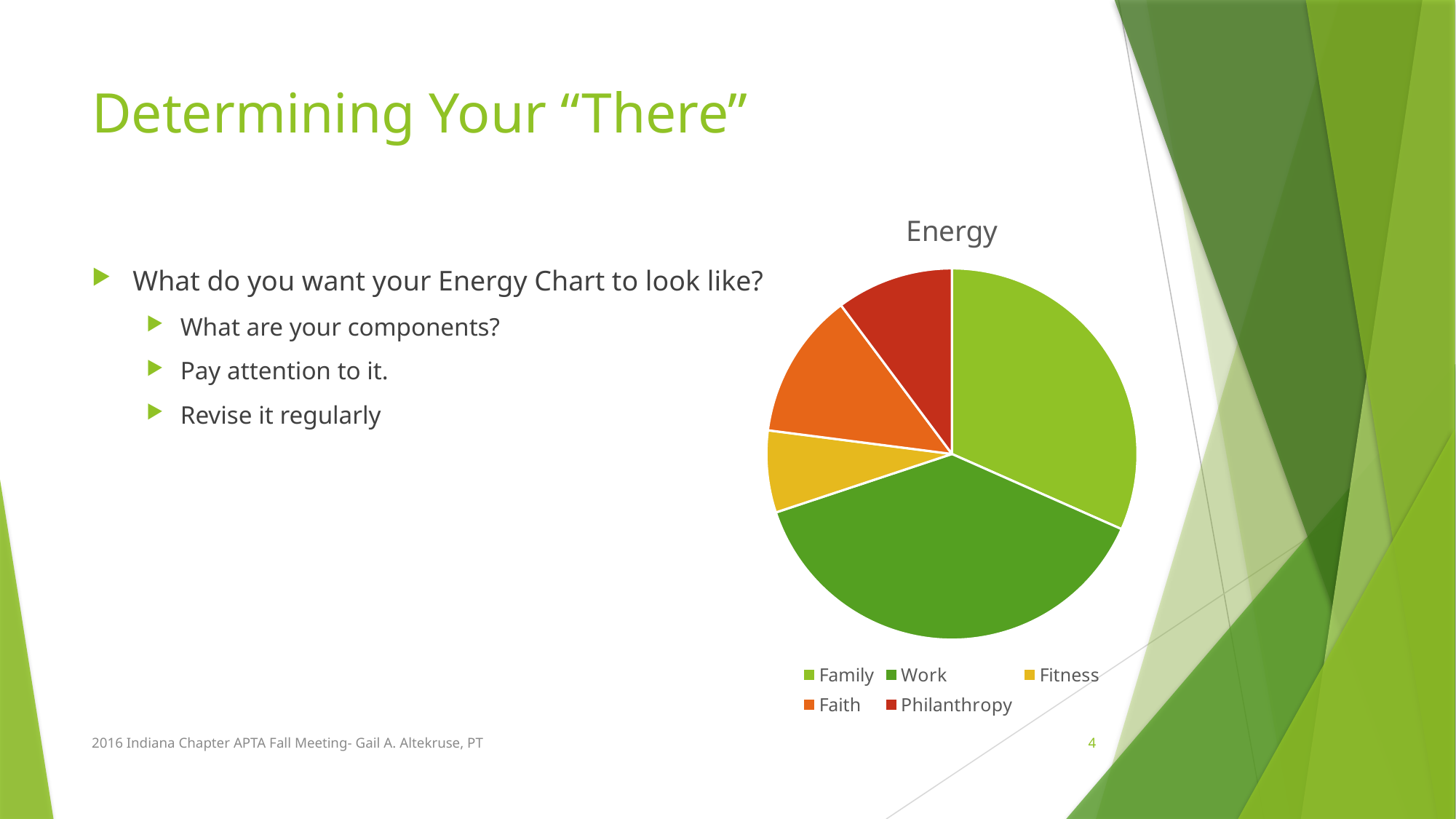
In the Energy pie chart, which slice is larger, Work or Family? Work How many entries does the legend of the Energy chart list? 5 In the Energy pie chart, which slice is larger, Work or Philanthropy? Work What is the title of the chart? Energy Which category has the largest slice in the Energy pie chart? Work In the Energy pie chart, which slice is larger, Faith or Fitness? Faith Which category is shown in red in the Energy pie chart? Philanthropy What kind of chart is shown on the slide? Pie chart Which category has the smallest slice in the Energy pie chart? Fitness How many slices does the Energy pie chart have? 5